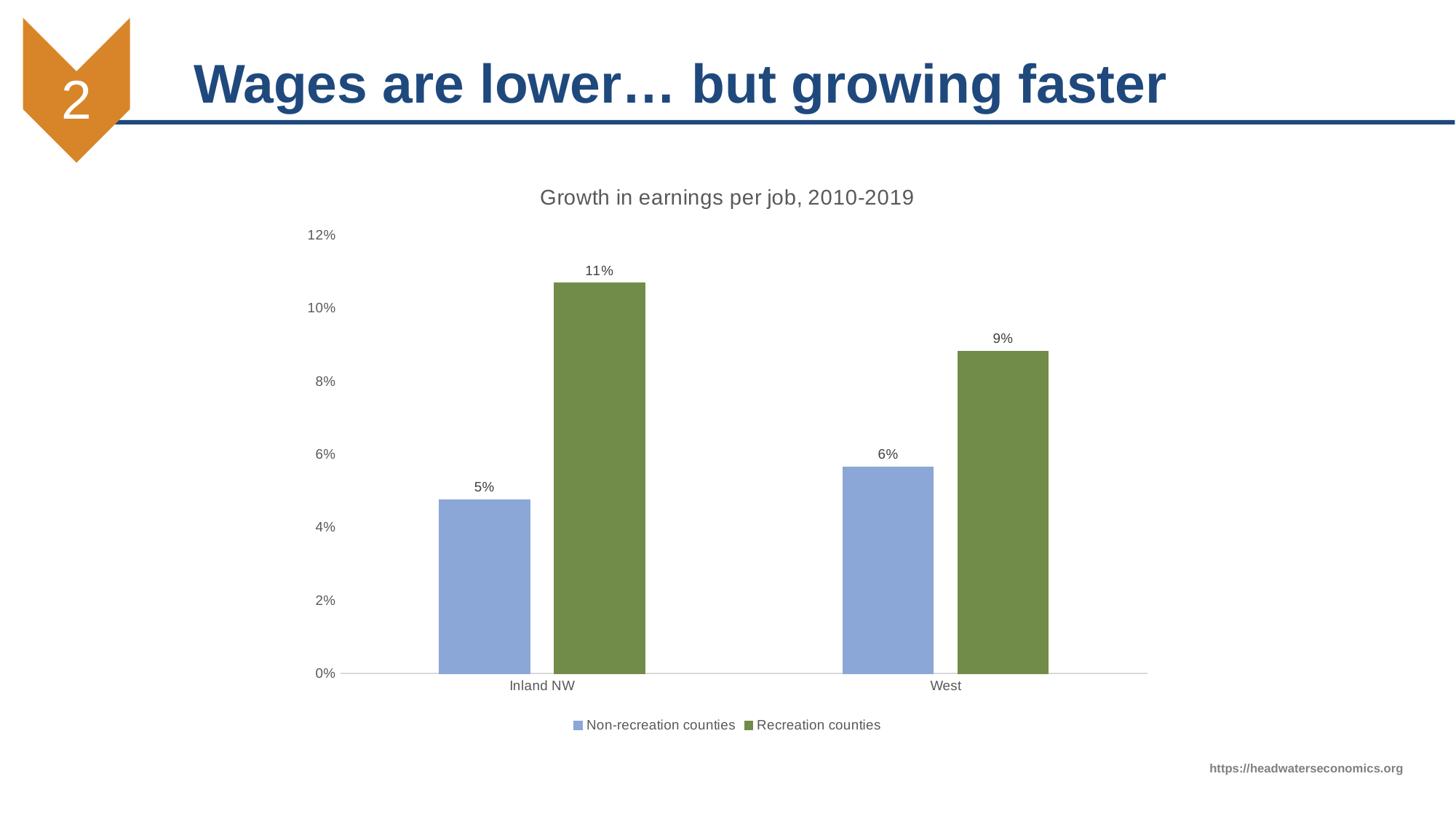
What kind of chart is shown on the slide? Bar chart What is the difference between Recreation counties and Non-recreation counties in Inland NW? 6% What is the growth in earnings per job for Non-recreation counties in West? 6% What is the growth in earnings per job for Non-recreation counties in Inland NW? 5% Which region has the highest value for Recreation counties? Inland NW Is the value for Recreation counties in Inland NW greater or less than 10%? greater How many series does the legend list? 2 Which region has the lowest value for Non-recreation counties? Inland NW What is the growth in earnings per job for Recreation counties in West? 9% What is the growth in earnings per job for Recreation counties in Inland NW? 11% In West, which series has the larger value: Non-recreation counties or Recreation counties? Recreation counties How many regions are shown on the x axis? 2